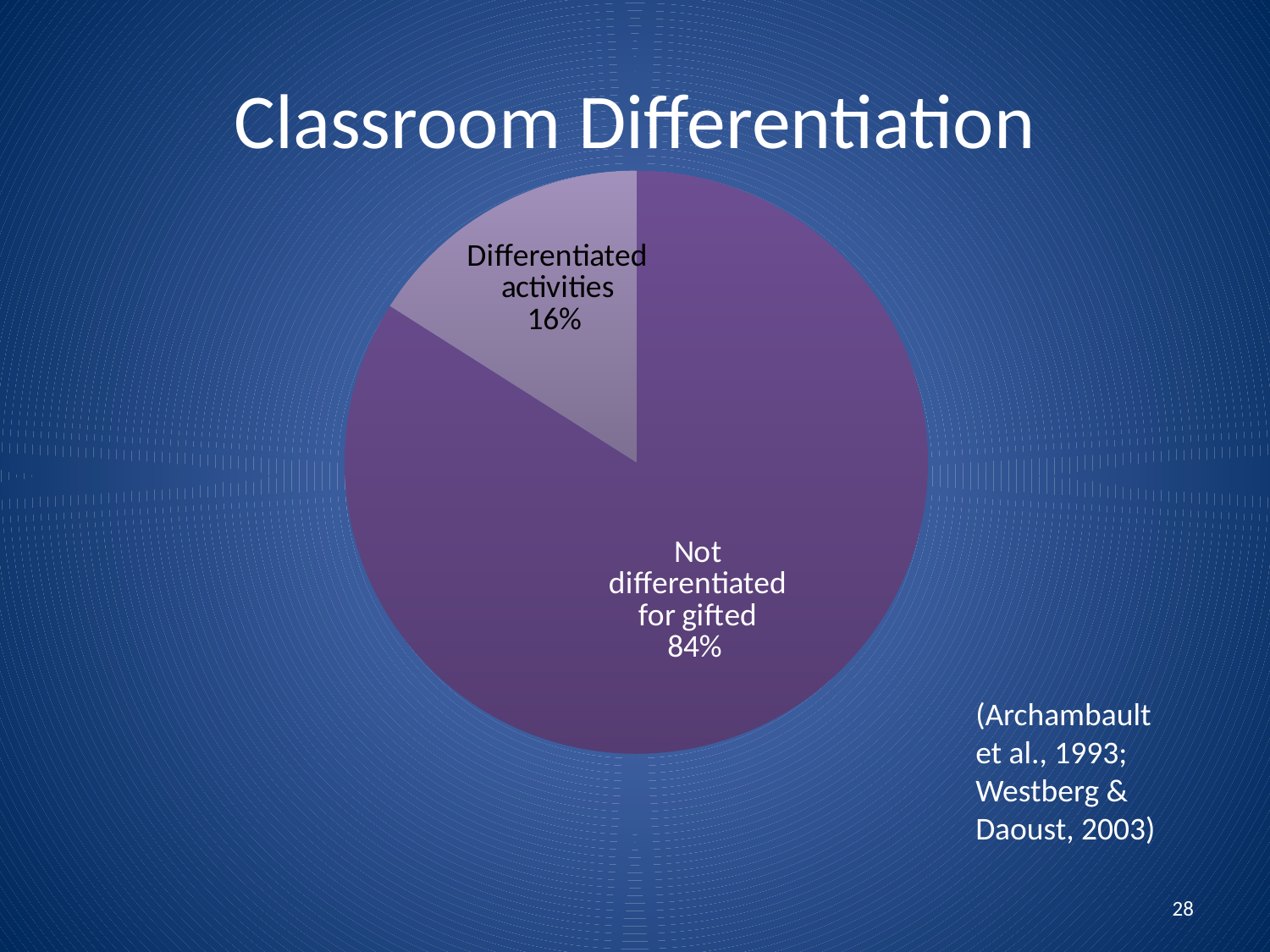
Which slice of the pie is the smallest? Differentiated activities Which is larger, the "Differentiated activities" slice or the "Not differentiated for gifted" slice? Not differentiated for gifted What is the title of the chart on the slide? Classroom Differentiation What share of the pie is labelled "Differentiated activities"? 16% How many slices does the pie chart have? 2 Which slice of the pie is the largest? Not differentiated for gifted What is the difference in percentage points between the "Not differentiated for gifted" slice and the "Differentiated activities" slice? 68 Which slice of the pie is shown in the lighter colour? Differentiated activities What share of the pie is labelled "Not differentiated for gifted"? 84% What kind of chart is shown on the slide? pie chart